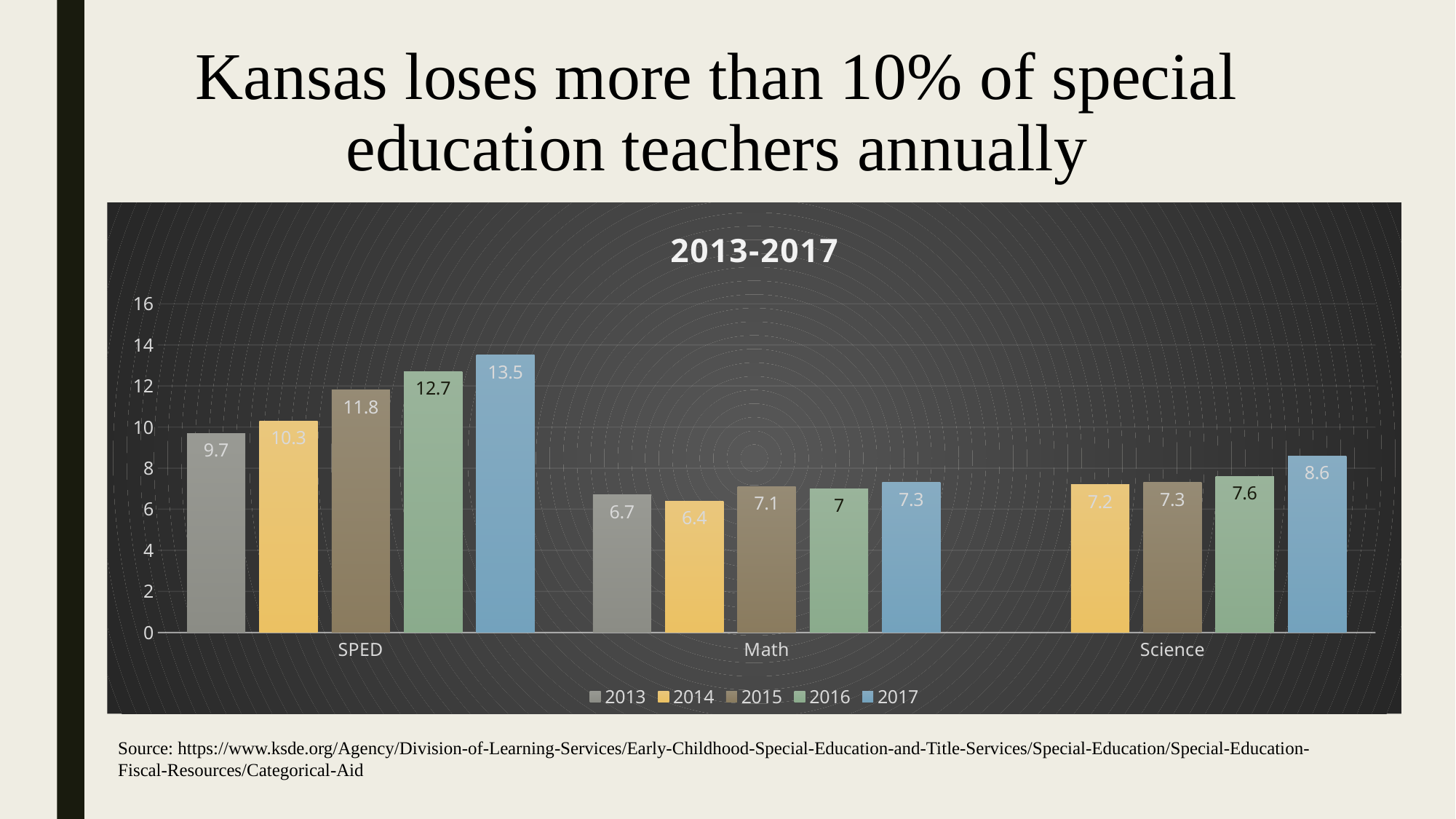
Which year has the highest value for SPED? 2017 What is the value for Science in 2016? 7.6 What is the title of the chart? 2013-2017 How many categories are shown on the x axis? 3 What kind of chart is shown on the slide? Bar chart Which is larger, the Science value for 2017 or the Math value for 2017? Science 2017 How many series does the legend list? 5 What is the value for Math in 2014? 6.4 Which year has the lowest value for Math? 2014 Is the value for SPED in 2015 greater or less than 10? greater What is the value for SPED in 2017? 13.5 What is the difference between the SPED values for 2017 and 2013? 3.8